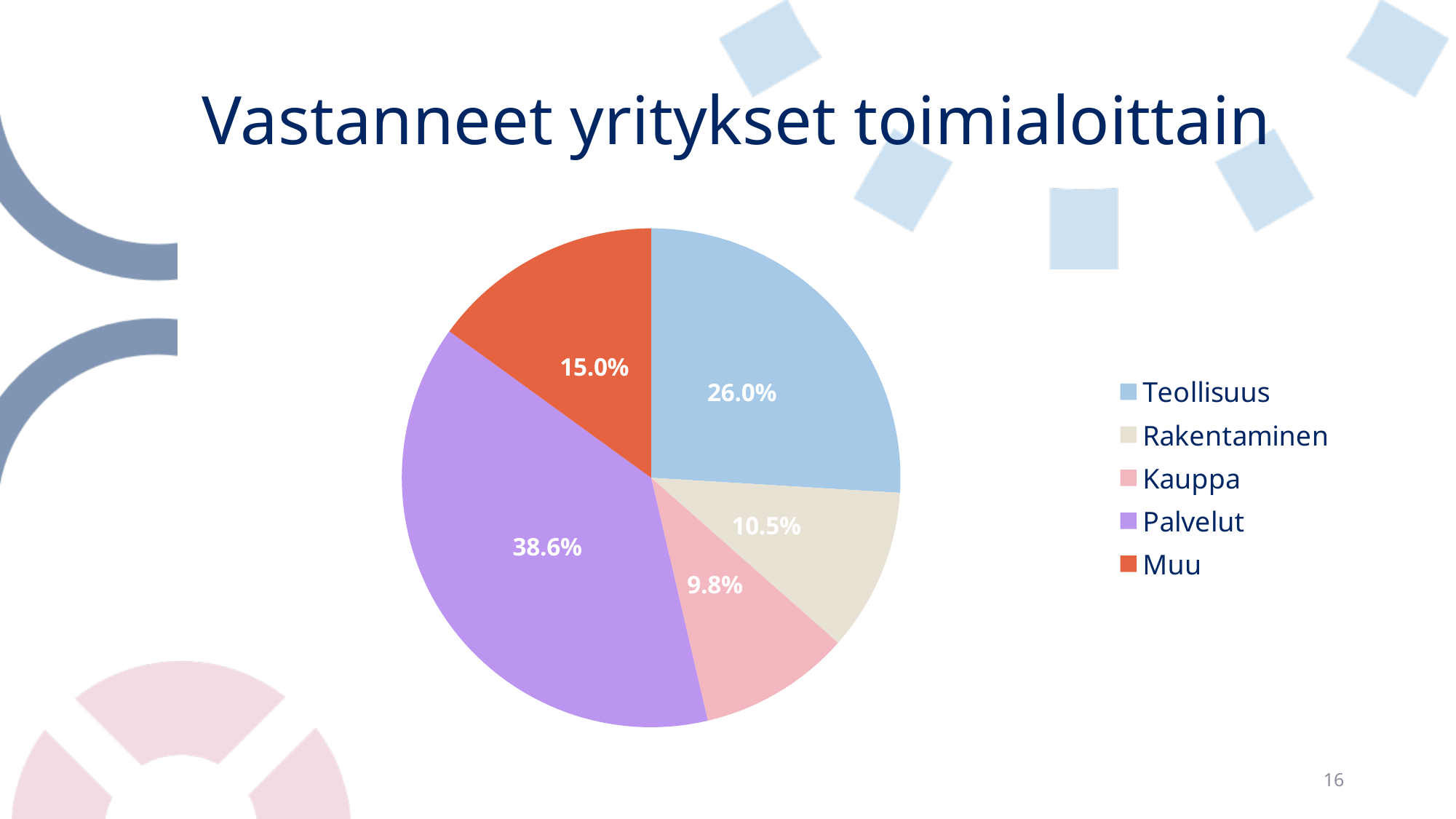
Which category has the smallest slice of the pie? Kauppa What is the value shown for Muu? 15.0% What is the value shown for Rakentaminen? 10.5% What is the difference in percentage points between Palvelut and Teollisuus? 12.6 Which is larger, the share for Muu or the share for Rakentaminen? Muu What is the value shown for Kauppa? 9.8% Which category has the largest slice of the pie? Palvelut How many categories does the pie chart have? 5 What type of chart is shown on the slide? pie chart What is the title of the chart on the slide? Vastanneet yritykset toimialoittain What share of the pie does Palvelut have? 38.6% What is the value shown for Teollisuus? 26.0%